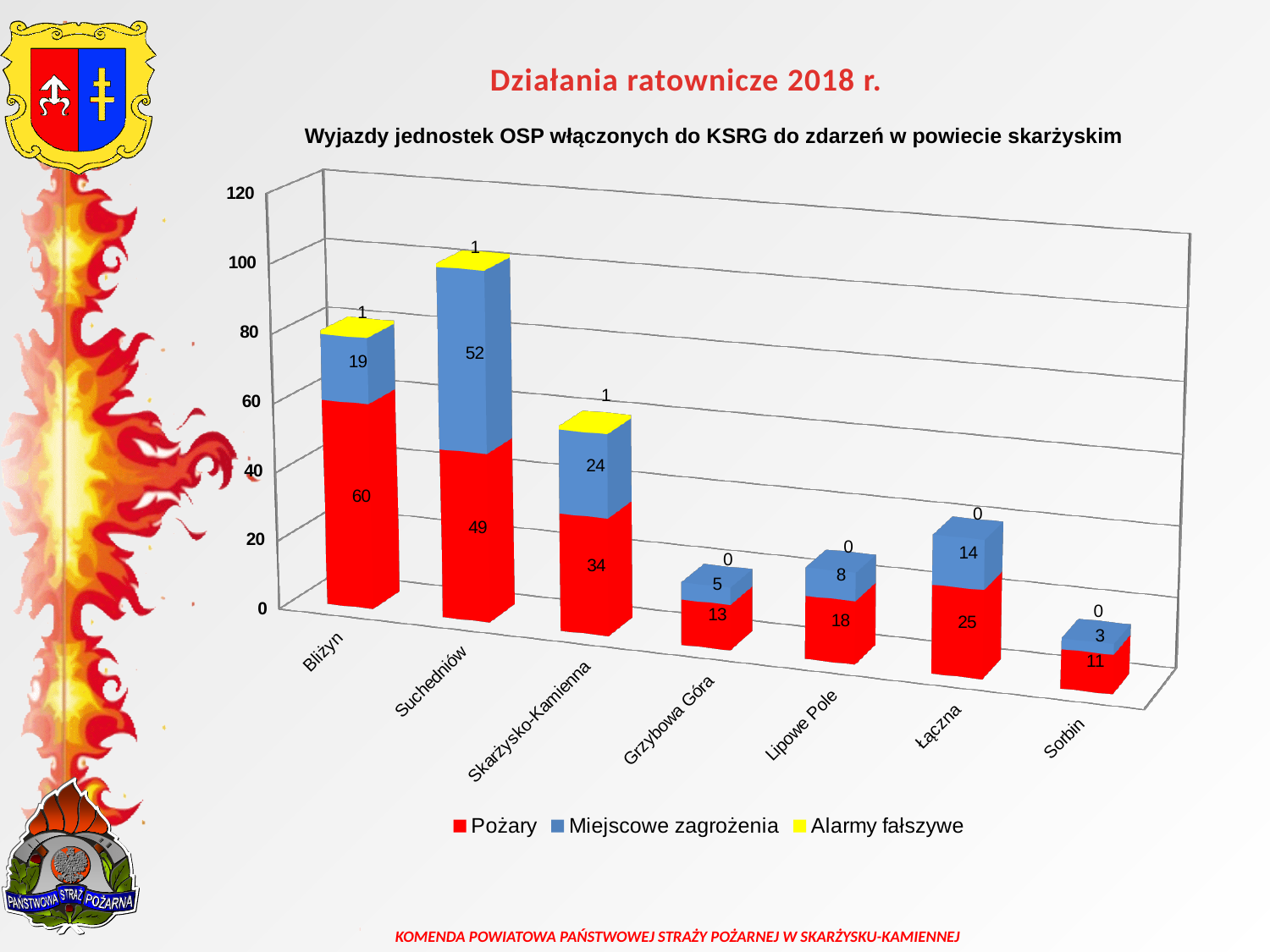
What is the value of Pożary for Bliżyn? 60 What is the value of Alarmy fałszywe for Skarżysko-Kamienna? 1 Which is larger: Miejscowe zagrożenia for Skarżysko-Kamienna or for Bliżyn? Skarżysko-Kamienna What is the title of the chart? Wyjazdy jednostek OSP włączonych do KSRG do zdarzeń w powiecie skarżyskim What is the difference between the Pożary values for Łączna and Lipowe Pole? 7 How many categories (units) are shown on the x axis? 7 What is the value of Miejscowe zagrożenia for Suchedniów? 52 How many series does the legend list? 3 Which category has the highest value for Pożary? Bliżyn What type of chart is shown on the slide? Stacked bar chart Which category has the lowest value for Miejscowe zagrożenia? Sorbin What is the total of the stacked bar for Suchedniów? 102